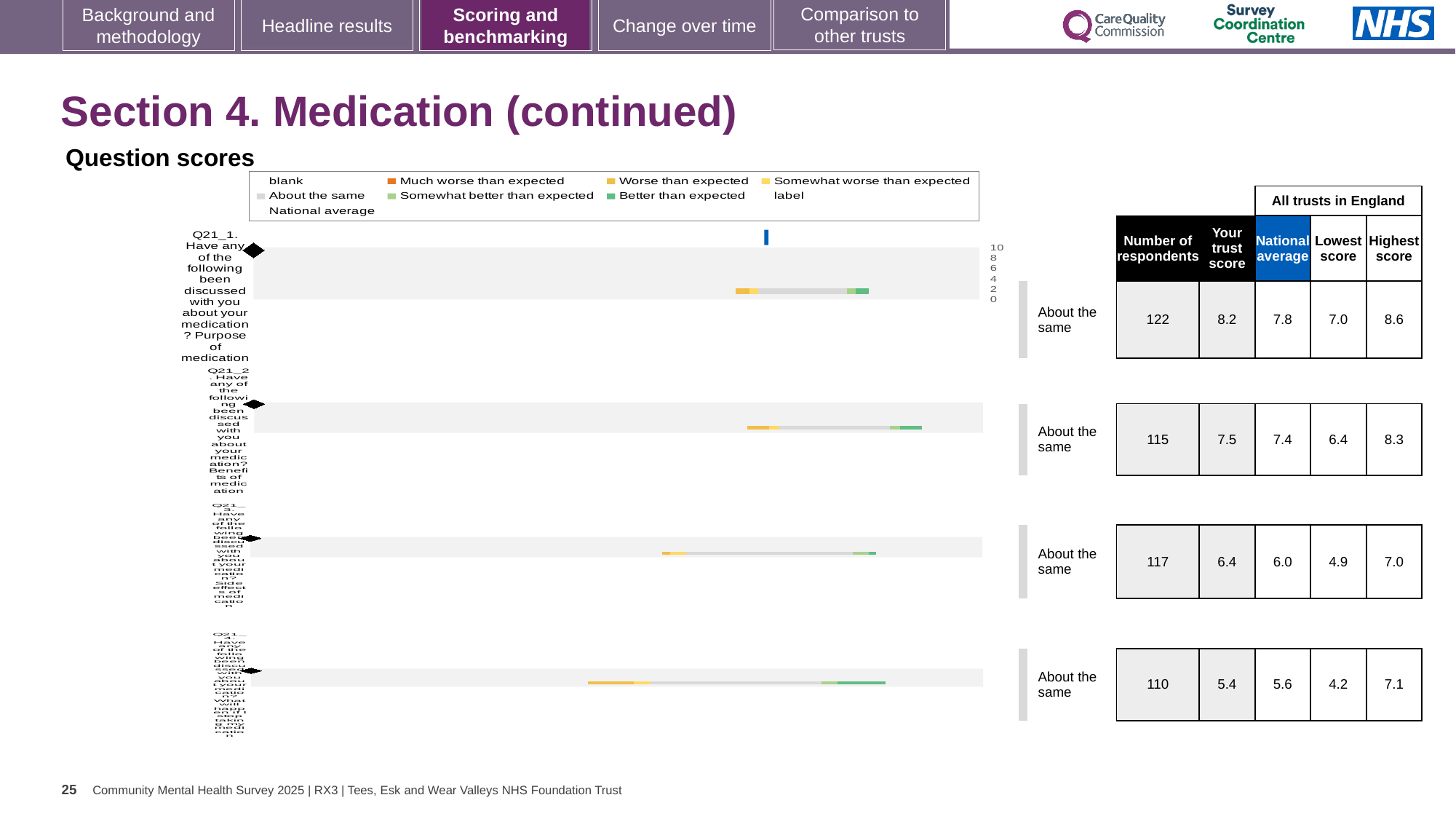
What colour does the legend use for 'Better than expected'? green For Q21_4, which is larger: the trust score or the national average? national average In the table beside the chart, what is the national average for Q21_2 (Benefits of medication)? 7.4 What kind of chart is shown under 'Question scores'? bar chart What is the difference between the trust score and the national average for Q21_1? 0.4 What is the title shown above the chart? Question scores In the table beside the chart, what is the trust score for Q21_1 (Purpose of medication)? 8.2 In the table beside the chart, what is the highest score for Q21_4? 7.1 In the table beside the chart, what is the lowest score for Q21_3 (Side effects of medication)? 4.9 In the table beside the chart, what is the number of respondents for Q21_1 (Purpose of medication)? 122 How many questions (bars) are plotted in the 'Question scores' chart? 4 Which question has the highest trust score in the table beside the chart? Q21_1